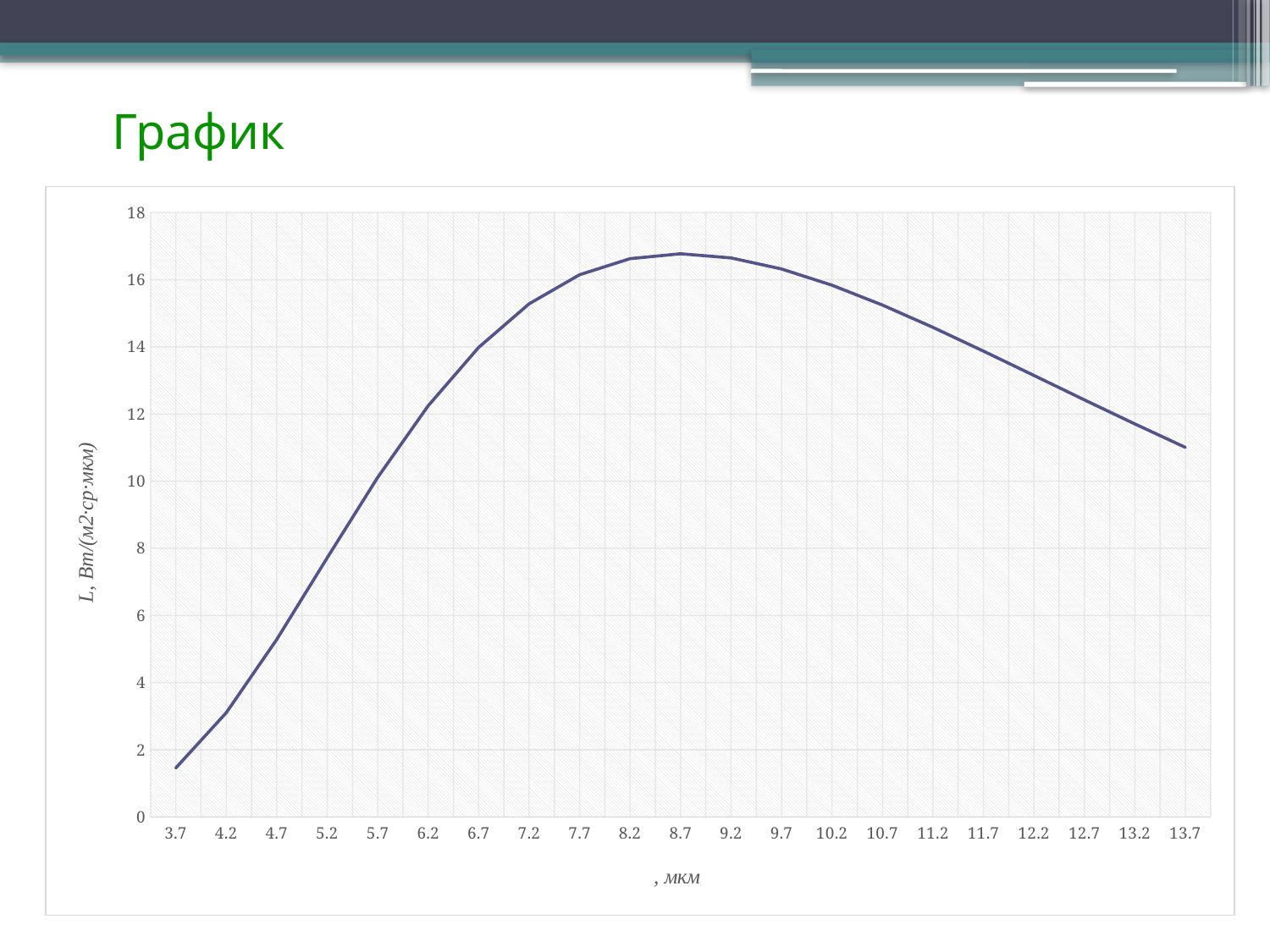
Is the value at x = 7.2 greater or less than 14? greater At which x value does the curve reach its highest point? 8.7 Does the curve rise or fall between x = 3.7 and x = 8.7? rise Is the value at x = 13.7 greater or less than 10? greater What is the title of the slide chart? График What kind of chart is shown on the slide? line chart How many x-axis tick values are shown on the chart? 21 Which is larger, the value at x = 3.7 or the value at x = 13.7? 13.7 What is the label of the vertical axis? L, Вт/(м2·ср·мкм) Is the value at x = 8.7 greater or less than 16? greater At which x value is the plotted value lowest? 3.7